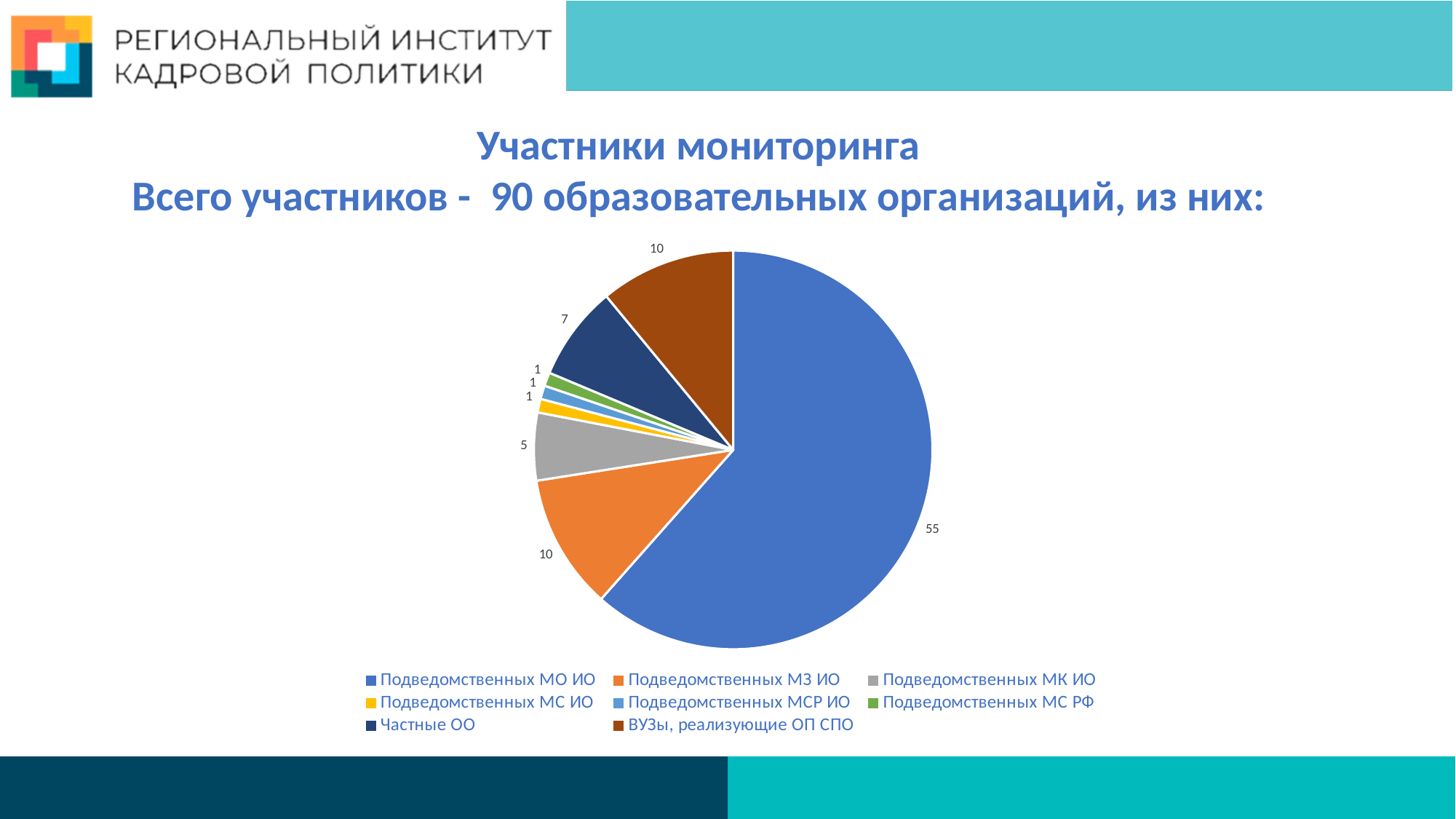
What is the difference between the values for Подведомственных МО ИО and Подведомственных МЗ ИО? 45 What kind of chart is shown on the slide? pie chart What is the difference between the values for Частные ОО and Подведомственных МК ИО? 2 How many categories does the pie chart have? 8 Which is larger, the value for Частные ОО or the value for Подведомственных МК ИО? Частные ОО What is the value for Подведомственных МК ИО? 5 What is the title of the chart? Участники мониторинга Which category has the largest slice of the pie? Подведомственных МО ИО What is the value for Частные ОО? 7 What is the value for Подведомственных МО ИО? 55 What is the value for ВУЗы, реализующие ОП СПО? 10 What is the value for Подведомственных МЗ ИО? 10